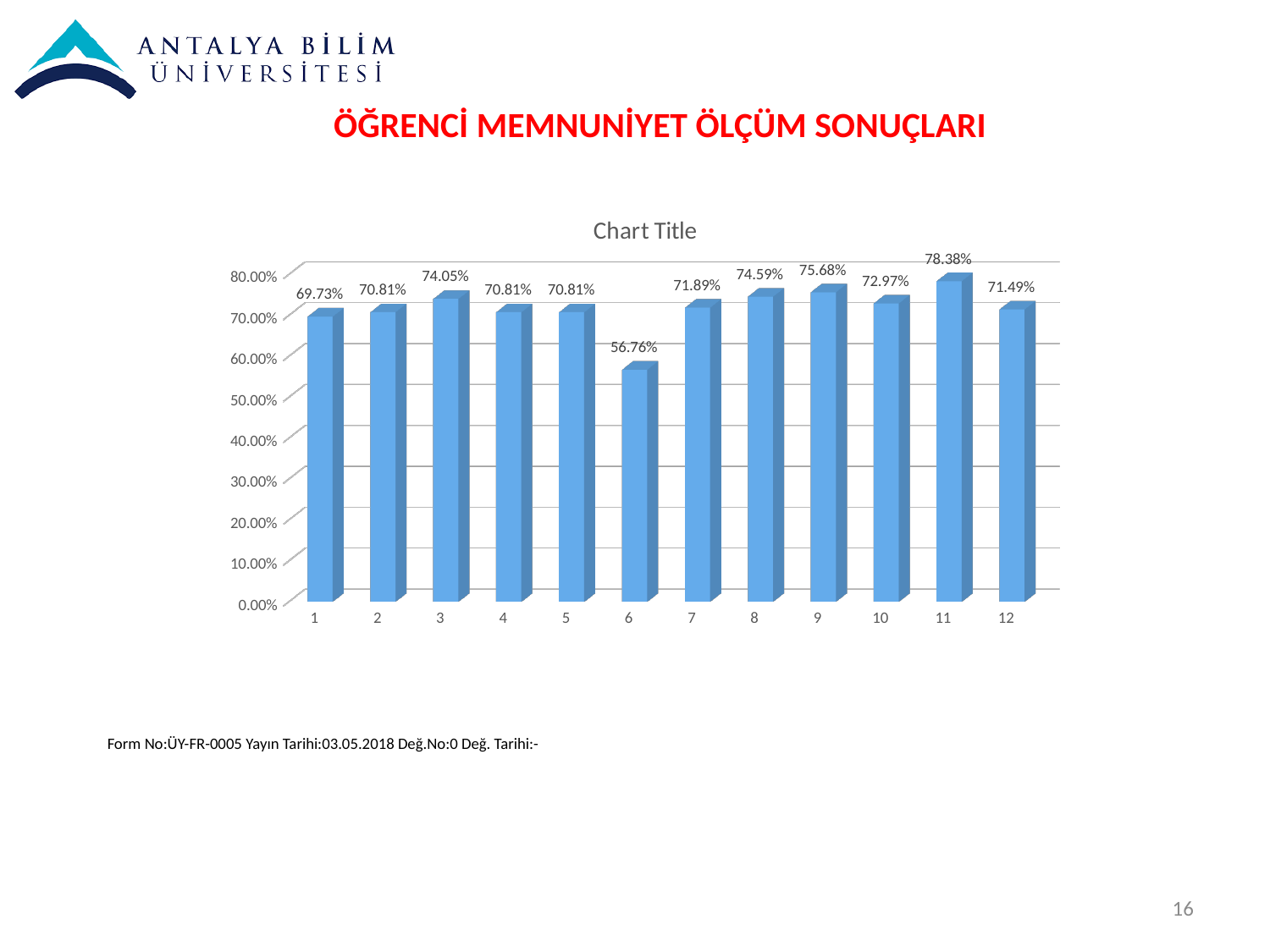
How many categories are shown on the x axis? 12 What is the value for category 6? 56.76% What is the value for category 10? 72.97% What kind of chart is shown? bar chart What is the difference between the values for category 11 and category 6? 21.62% Which is larger, the value for category 3 or the value for category 9? 9 Which category has the highest value? 11 Is the value for category 6 greater or less than 60.00%? less Which category has the lowest value? 6 What is the title shown above the chart? Chart Title What is the value for category 11? 78.38% What is the value for category 1? 69.73%